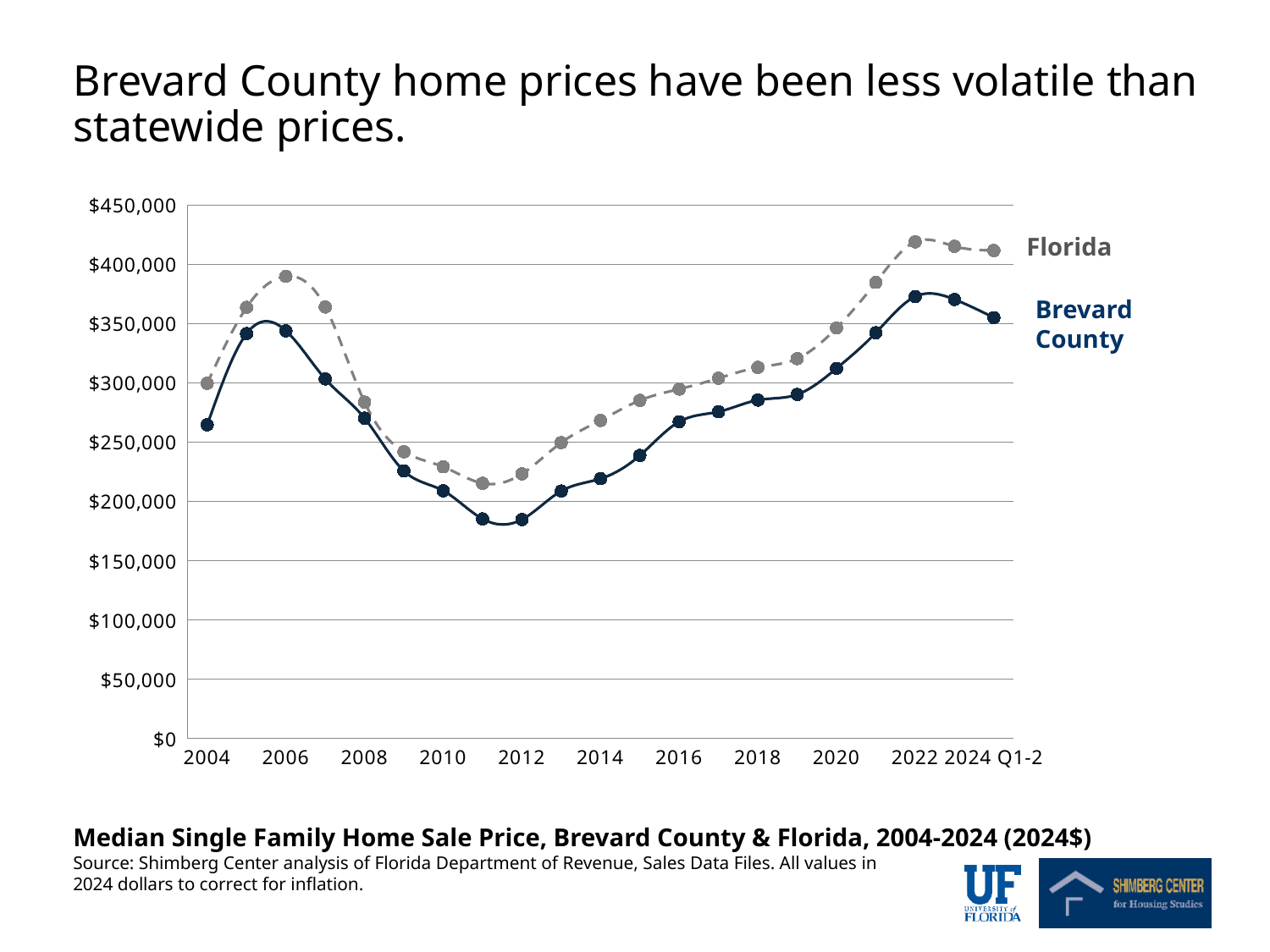
Is the Brevard County value for 2022 greater or less than $400,000? less In 2006, which series has the higher value, Florida or Brevard County? Florida Is the Brevard County value for 2004 greater or less than $250,000? greater What are the two series plotted on the chart? Florida and Brevard County Do the Brevard County values rise or fall between 2012 and 2022? Rise Do the Florida values rise or fall between 2006 and 2011? Fall Is the Florida value for 2022 greater or less than $400,000? greater What is the title of the chart? Median Single Family Home Sale Price, Brevard County & Florida, 2004-2024 (2024$) What kind of chart is shown on the slide? Line chart How many series does the chart show? 2